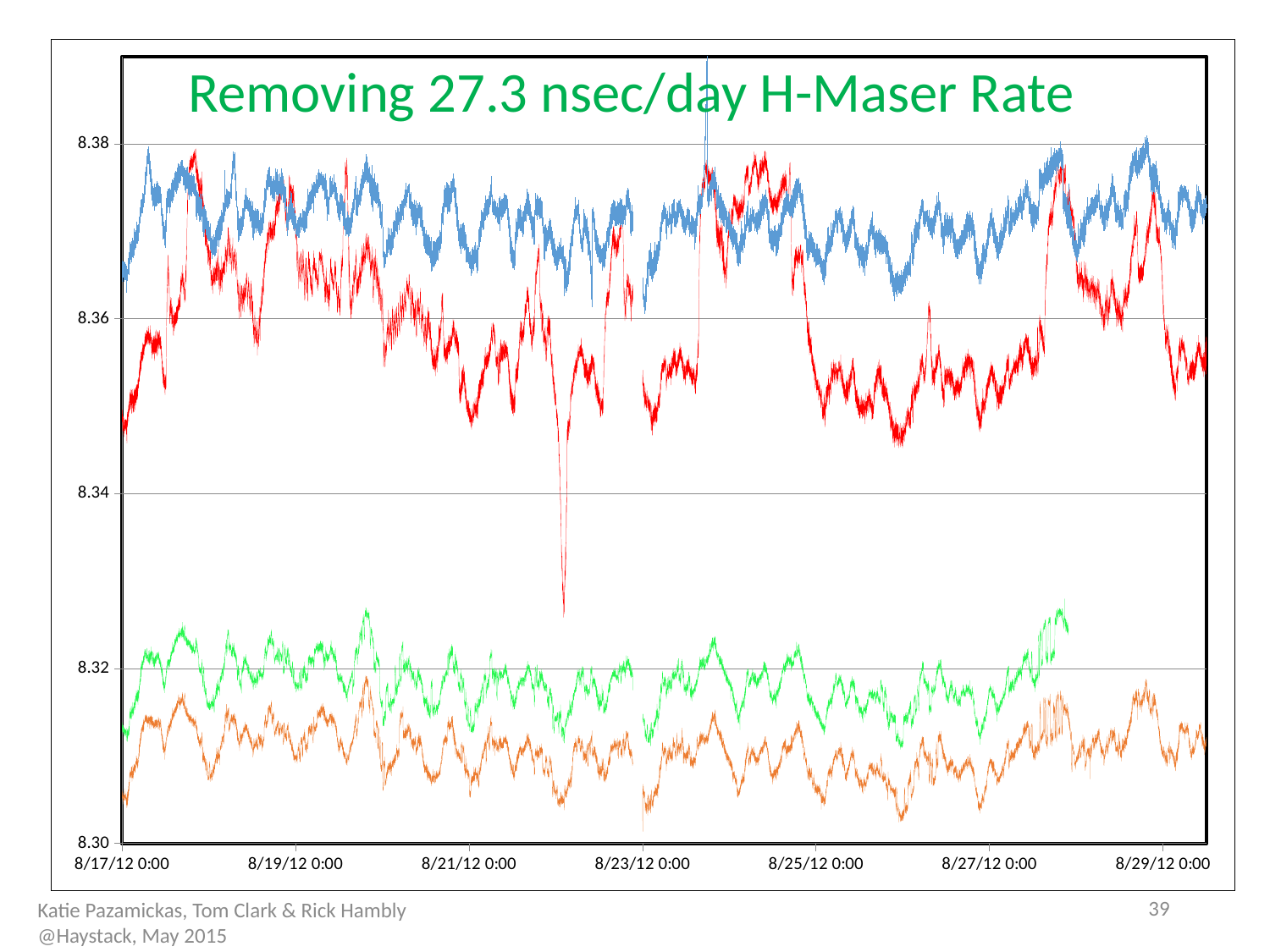
Which line has higher values, the red line or the green line? red Is the lowest point of the red line (near 8/22) greater or less than 8.34? less How many date labels are shown along the x axis? 7 What kind of chart is shown on the slide? line chart What is the title of the chart? Removing 27.3 nsec/day H-Maser Rate Which coloured line sits lowest on the chart overall? orange How many separate lines (series) are plotted on the chart? 4 Is the blue line greater or less than 8.36 across the whole chart? greater What is the lowest value labelled on the y axis? 8.30 Is the orange line greater or less than 8.32 across the whole chart? less Which coloured line sits highest on the chart overall? blue Which line has higher values, the blue line or the orange line? blue